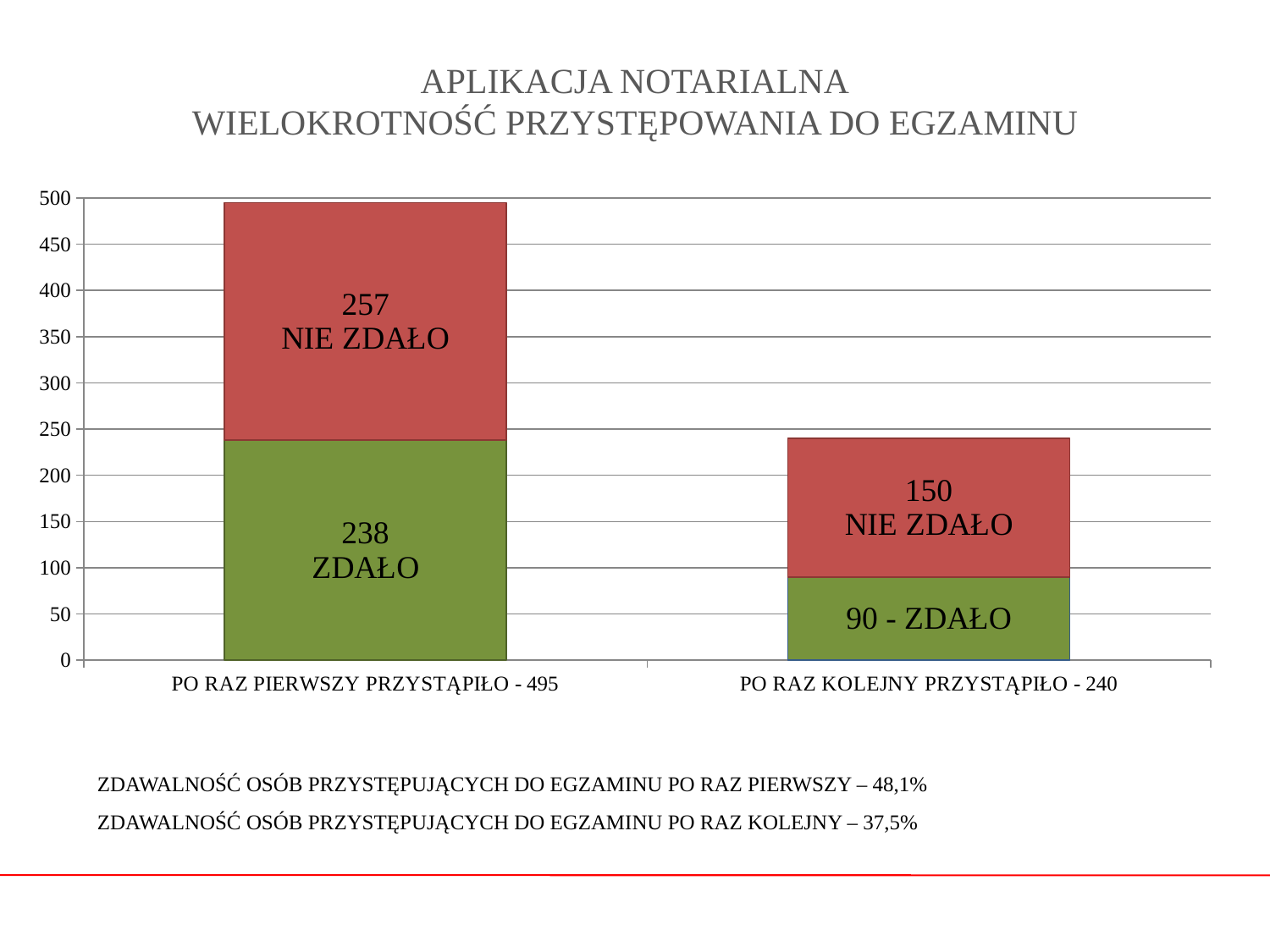
What kind of chart is shown on the slide? stacked bar chart Which category has the higher total number of exam takers, PO RAZ PIERWSZY PRZYSTĄPIŁO or PO RAZ KOLEJNY PRZYSTĄPIŁO? PO RAZ PIERWSZY PRZYSTĄPIŁO How many categories are shown on the x axis of the chart? 2 How many people did not pass (NIE ZDAŁO) among those who took the exam for the first time (PO RAZ PIERWSZY PRZYSTĄPIŁO)? 257 How many people passed (ZDAŁO) among those who took the exam for the first time (PO RAZ PIERWSZY PRZYSTĄPIŁO)? 238 What is the total height of the stacked bar for PO RAZ KOLEJNY PRZYSTĄPIŁO? 240 What is the total height of the stacked bar for PO RAZ PIERWSZY PRZYSTĄPIŁO? 495 What colour represents the NIE ZDAŁO (did not pass) segment in the chart? red What is the difference between the number who did not pass and the number who passed among repeat takers (PO RAZ KOLEJNY PRZYSTĄPIŁO)? 60 What is the difference between the number who did not pass and the number who passed among first-time takers (PO RAZ PIERWSZY PRZYSTĄPIŁO)? 19 How many people did not pass (NIE ZDAŁO) among those who took the exam again (PO RAZ KOLEJNY PRZYSTĄPIŁO)? 150 How many people passed (ZDAŁO) among those who took the exam again (PO RAZ KOLEJNY PRZYSTĄPIŁO)? 90